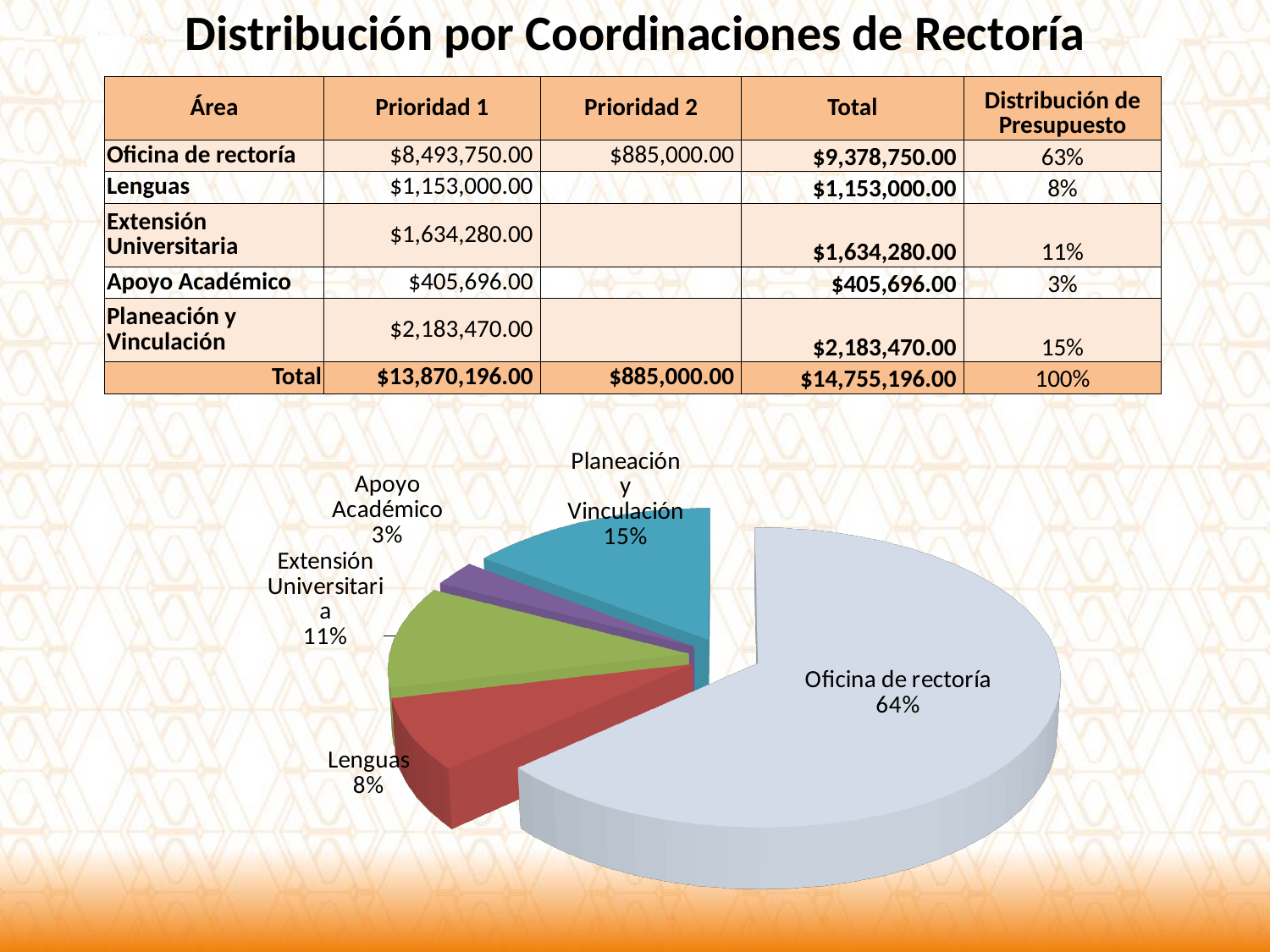
What share of the pie chart does Apoyo Académico have? 3% In the pie chart, what is the difference in percentage points between Planeación y Vinculación and Lenguas? 7 percentage points What kind of chart is shown on the slide? Pie chart What share of the pie chart does Lenguas have? 8% Which slice of the pie chart is the smallest? Apoyo Académico What is the title of the slide containing the pie chart? Distribución por Coordinaciones de Rectoría In the pie chart, which is larger: Planeación y Vinculación or Extensión Universitaria? Planeación y Vinculación How many slices does the pie chart have? 5 What share of the pie chart does Oficina de rectoría have? 64% Which slice of the pie chart is the largest? Oficina de rectoría